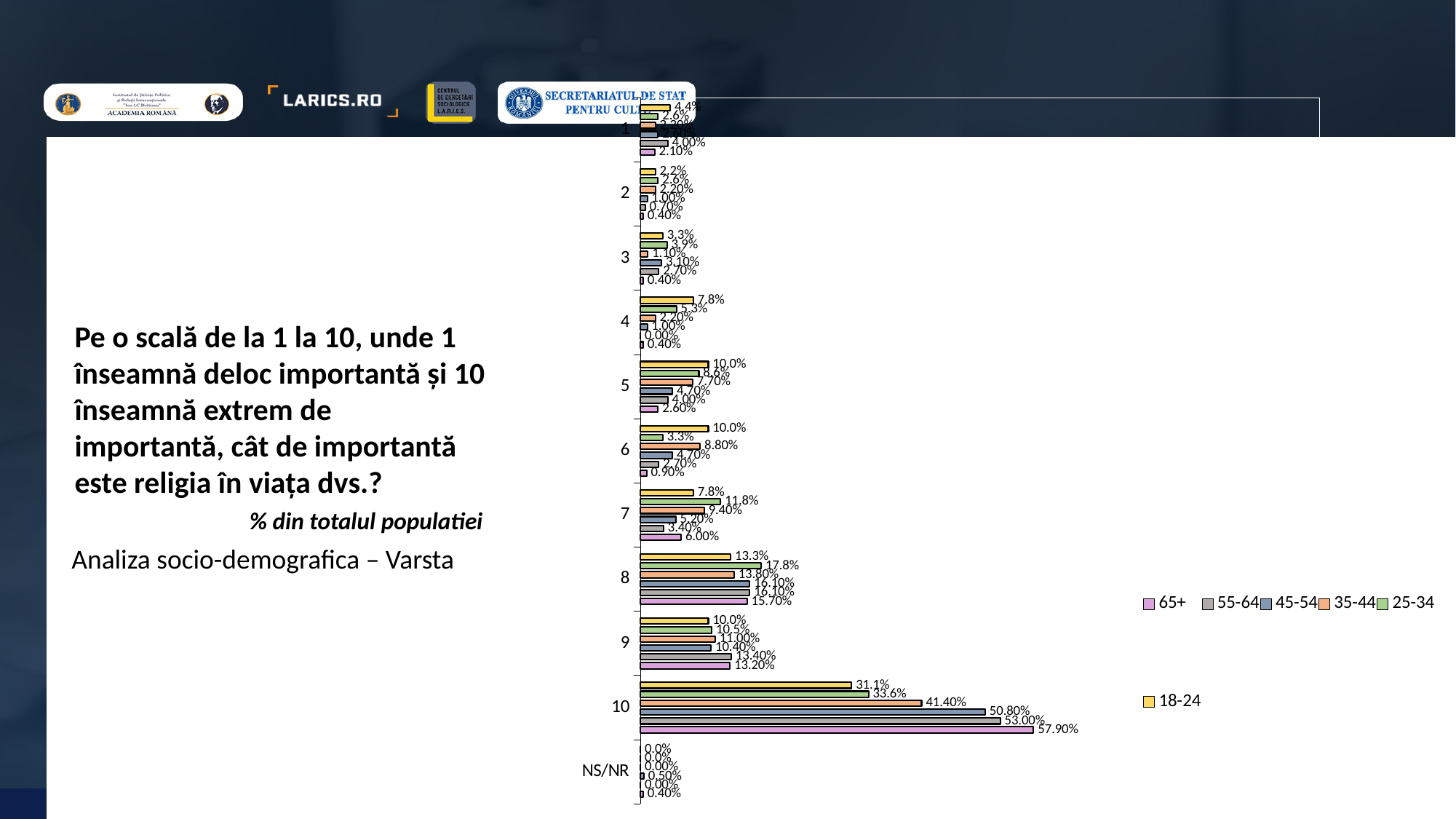
How many categories are shown on the vertical axis of the chart? 11 How many series does the legend list? 6 What is the value for the 18-24 series in category 10? 31.1% What is the difference between the 65+ and 18-24 values in category 10? 26.8% What is the value for the 65+ series in category 10? 57.90% Which age group has the highest value in category 10? 65+ What is the value for the 25-34 series in category 8? 17.8% What is the value for the 45-54 series in category 10? 50.80% What is the value for the 55-64 series in category 9? 13.40% What type of chart is shown on the slide? bar chart In category 7, which is larger: the value for 25-34 or the value for 35-44? 25-34 Which age group has the lowest value in category 10? 18-24